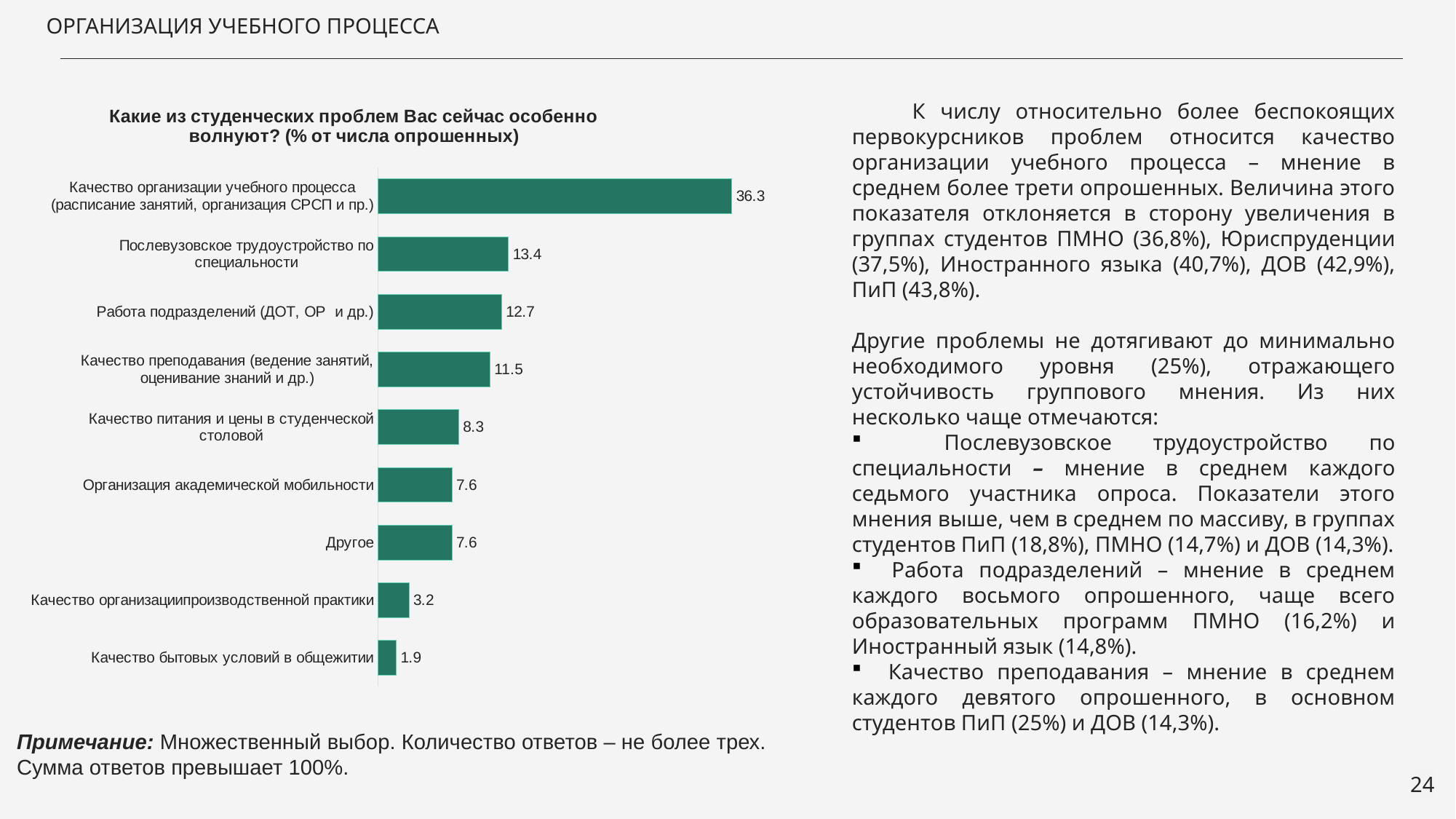
Which category has the highest value? Качество организации учебного процесса (расписание занятий, организация СРСП и пр.) What is the difference between the values for "Качество организации учебного процесса" and "Качество преподавания"? 24.8 What is the difference between the values for "Послевузовское трудоустройство по специальности" and "Работа подразделений (ДОТ, ОР и др.)"? 0.7 What is the title of the chart? Какие из студенческих проблем Вас сейчас особенно волнуют? (% от числа опрошенных) Which is larger: the value for "Качество преподавания (ведение занятий, оценивание знаний и др.)" or for "Качество питания и цены в студенческой столовой"? Качество преподавания (ведение занятий, оценивание знаний и др.) What value is shown for "Послевузовское трудоустройство по специальности"? 13.4 What value is shown for "Качество организации учебного процесса (расписание занятий, организация СРСП и пр.)"? 36.3 What type of chart is shown on the slide? Bar chart What value is shown for "Качество питания и цены в студенческой столовой"? 8.3 How many categories are shown in the chart? 9 Which category has the lowest value? Качество бытовых условий в общежитии What value is shown for "Качество бытовых условий в общежитии"? 1.9